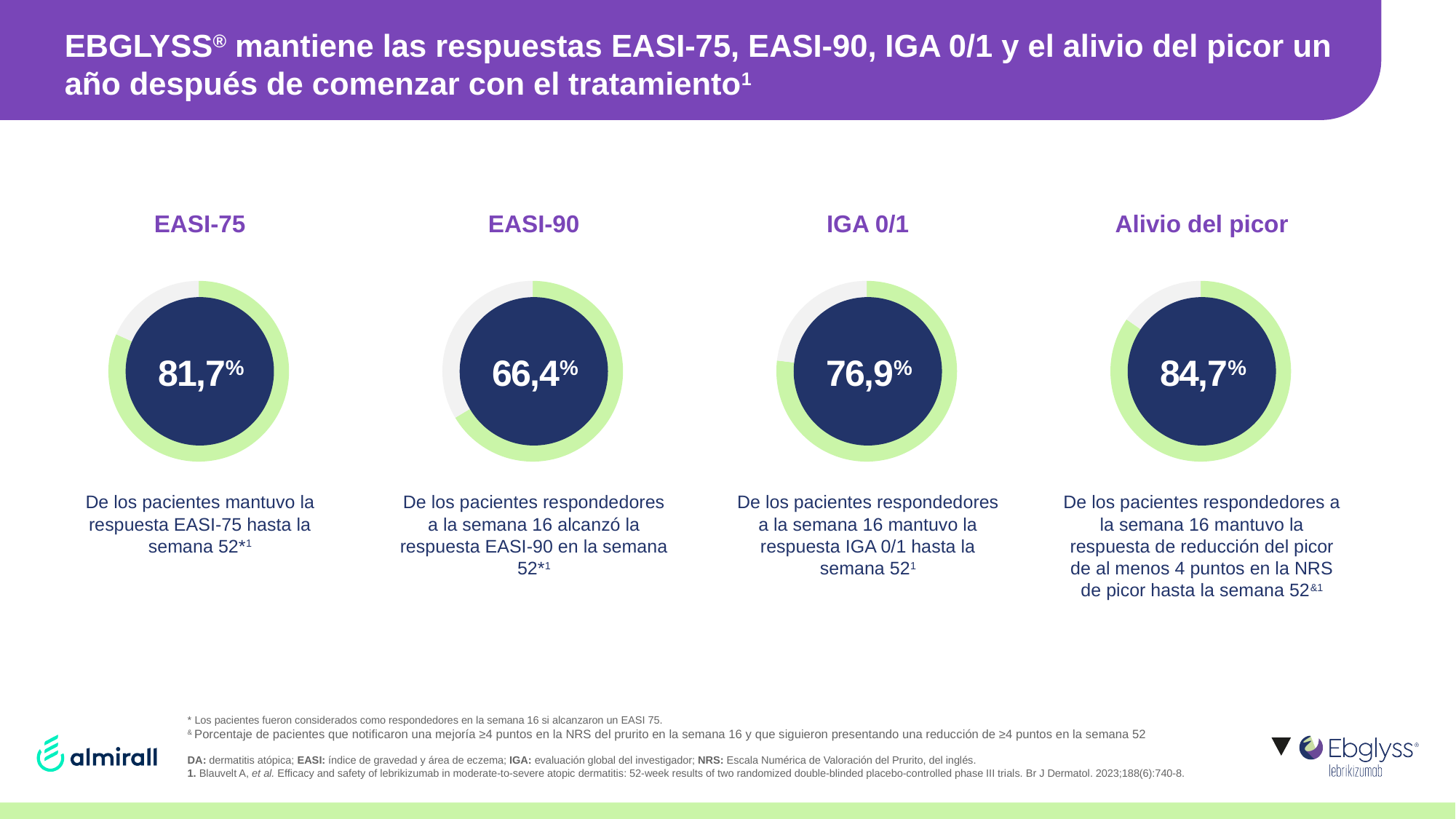
How many donut charts are shown on the slide? 4 Which of the four charts shows the lowest percentage? EASI-90 Which of the four charts shows the highest percentage? Alivio del picor What value is shown in the 'Alivio del picor' chart? 84,7% What is the difference between the 'Alivio del picor' value and the IGA 0/1 value? 7,8 percentage points What colour is the filled portion of the rings in the donut charts? Light green What value is shown in the IGA 0/1 chart? 76,9% What value is shown in the EASI-90 chart? 66,4% What is the difference between the EASI-75 value and the EASI-90 value? 15,3 percentage points What kind of chart is used to display the percentages on the slide? Donut chart Which is larger, the IGA 0/1 value or the EASI-90 value? IGA 0/1 What value is shown in the EASI-75 chart? 81,7%